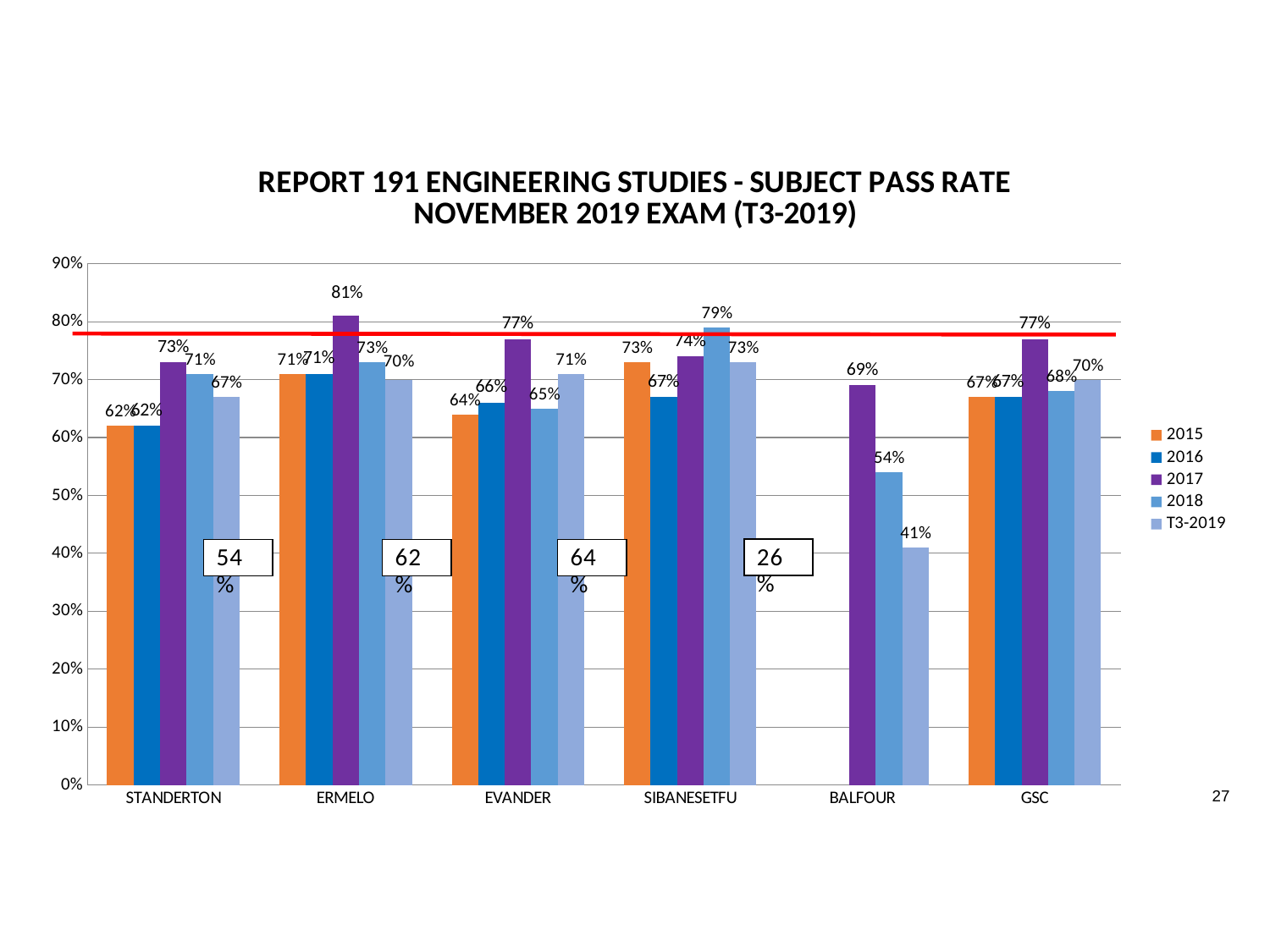
What is the difference between the 2017 and T3-2019 pass rates for BALFOUR? 28% Which series is shown in orange in the legend? 2015 How many campuses (categories) are shown on the x axis? 6 Is the 2018 value for BALFOUR greater or less than 60%? less What is the 2018 pass rate for SIBANESETFU? 79% What is the 2017 pass rate for ERMELO? 81% Which campus has the lowest T3-2019 pass rate? BALFOUR What type of chart is shown on the slide? bar chart Which is larger for EVANDER, the 2018 pass rate or the T3-2019 pass rate? T3-2019 Which campus has the highest 2017 pass rate? ERMELO How many series does the legend list? 5 What is the T3-2019 pass rate for BALFOUR? 41%